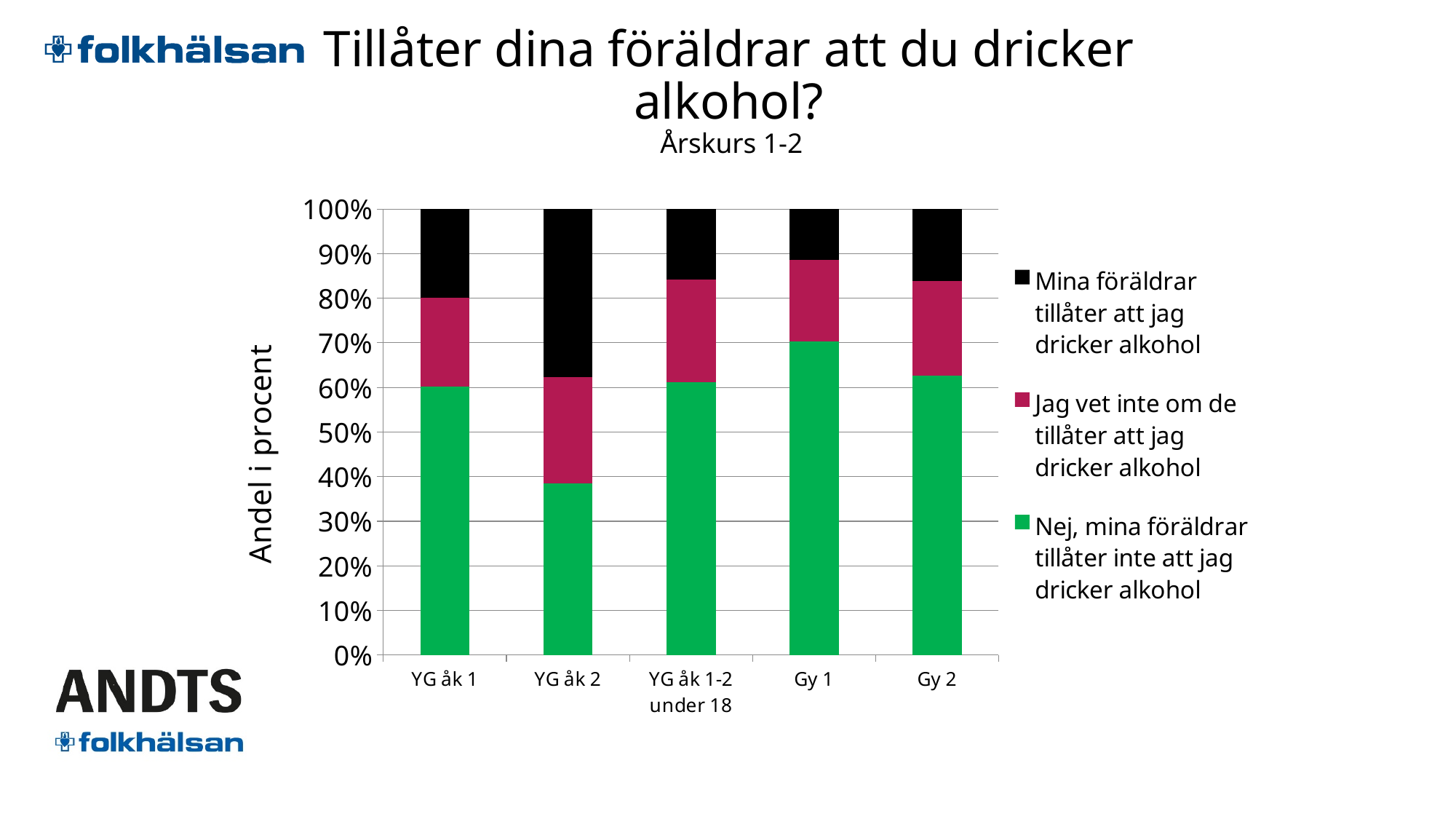
What is the label of the y axis? Andel i procent Which category has the lowest share of 'Nej, mina föräldrar tillåter inte att jag dricker alkohol'? YG åk 2 Is the share of 'Nej, mina föräldrar tillåter inte att jag dricker alkohol' for YG åk 2 greater or less than 40%? less What is the total of the stacked bar for Gy 2? 100% Which colour represents 'Jag vet inte om de tillåter att jag dricker alkohol' in the legend? magenta (dark pink) How many series does the legend list? 3 Which category has the highest share of 'Nej, mina föräldrar tillåter inte att jag dricker alkohol'? Gy 1 Which category has the largest share of 'Mina föräldrar tillåter att jag dricker alkohol'? YG åk 2 How many categories are shown on the x axis? 5 Is the share of 'Nej, mina föräldrar tillåter inte att jag dricker alkohol' for Gy 1 greater or less than 60%? greater What kind of chart is shown on the slide? stacked bar chart Which is larger: the share of 'Nej, mina föräldrar tillåter inte att jag dricker alkohol' for Gy 1 or for YG åk 1? Gy 1